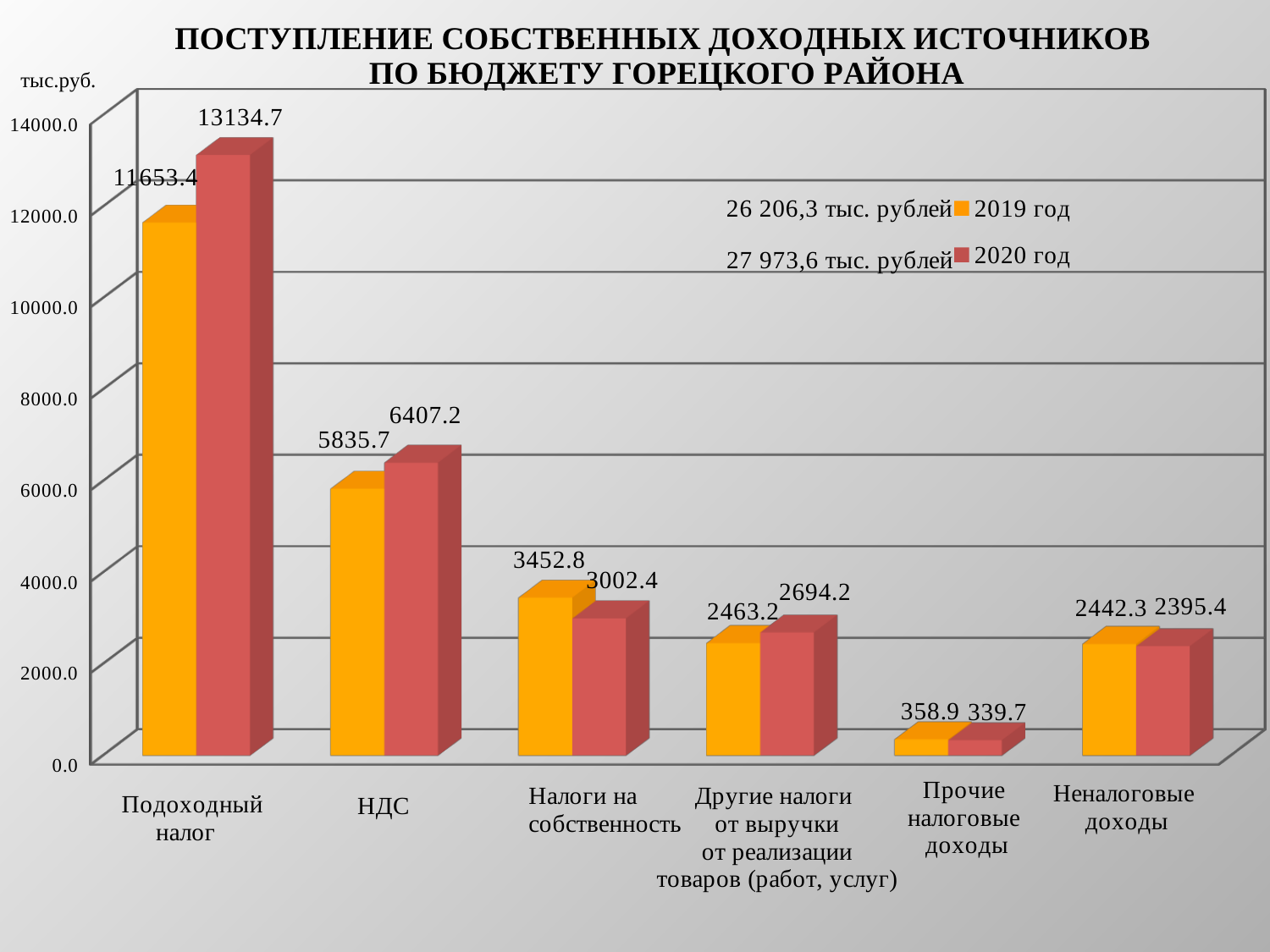
What is the value for НДС in the 2020 год series? 6407.2 How many categories are shown on the x axis? 6 What is the value for Подоходный налог in the 2019 год series? 11653.4 Which category has the highest value in the 2020 год series? Подоходный налог What kind of chart is shown on the slide? Bar chart What is the value for Прочие налоговые доходы in the 2019 год series? 358.9 What is the difference between the 2019 год and 2020 год values for Налоги на собственность? 450.4 For НДС, which series has the larger value, 2019 год or 2020 год? 2020 год What is the difference between the 2020 год and 2019 год values for Подоходный налог? 1481.3 What is the value for Неналоговые доходы in the 2020 год series? 2395.4 How many series does the legend list? 2 Which category has the lowest value in the 2019 год series? Прочие налоговые доходы